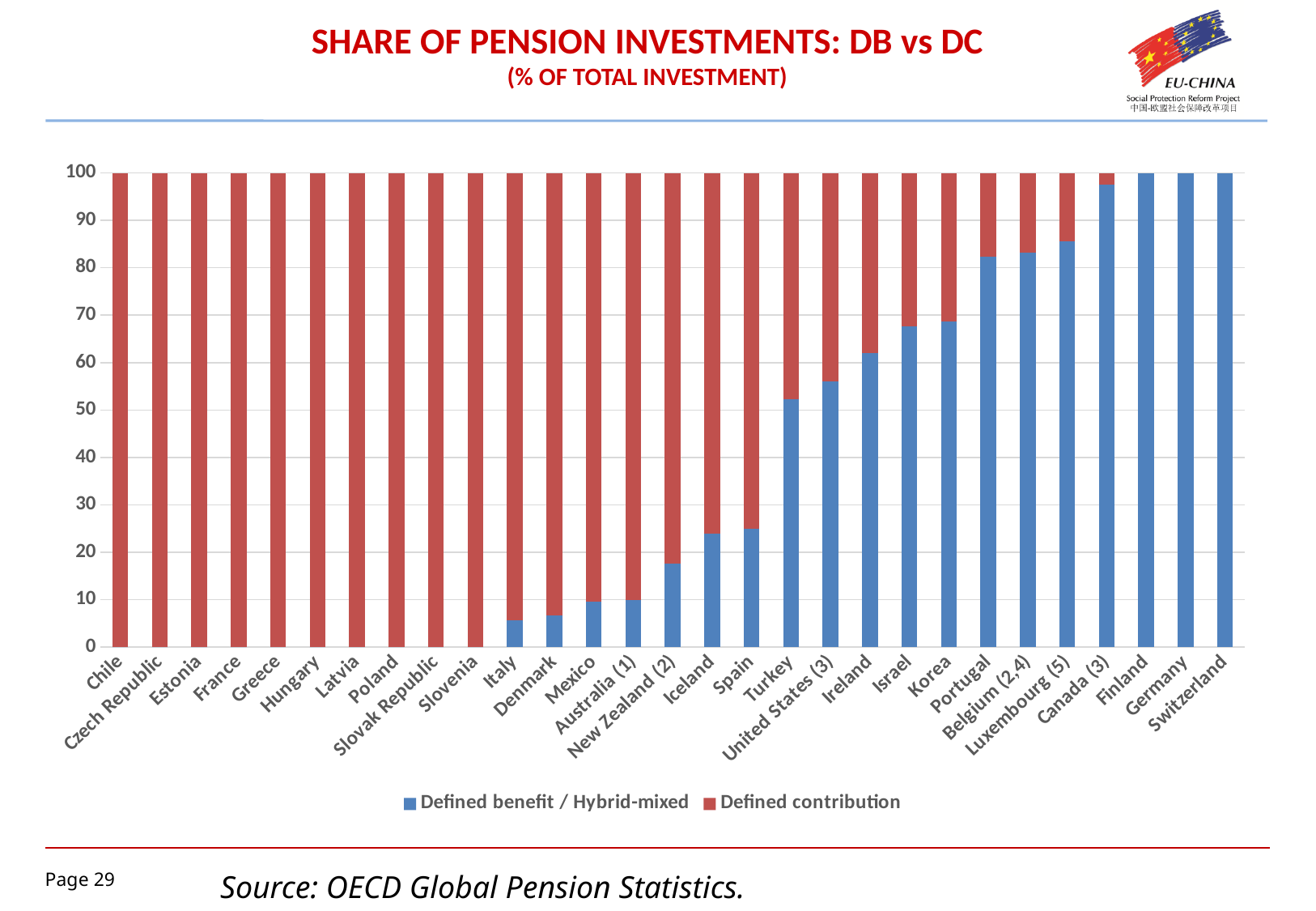
Is the Defined benefit / Hybrid-mixed value for Israel greater or less than 70? less What is the Defined contribution share for Chile? 100 How many countries are shown on the x axis? 29 How many series does the legend list? 2 Moving from left to right along the x axis, does the Defined benefit / Hybrid-mixed share rise or fall? Rise What kind of chart is shown on the slide? Stacked bar chart What are the two series named in the legend? Defined benefit / Hybrid-mixed; Defined contribution Is the Defined benefit / Hybrid-mixed value for Canada (3) greater or less than 90? greater Which has a larger Defined benefit / Hybrid-mixed share, Korea or Spain? Korea What is the Defined benefit / Hybrid-mixed share for Finland? 100 Is the Defined benefit / Hybrid-mixed value for Italy greater or less than 10? less